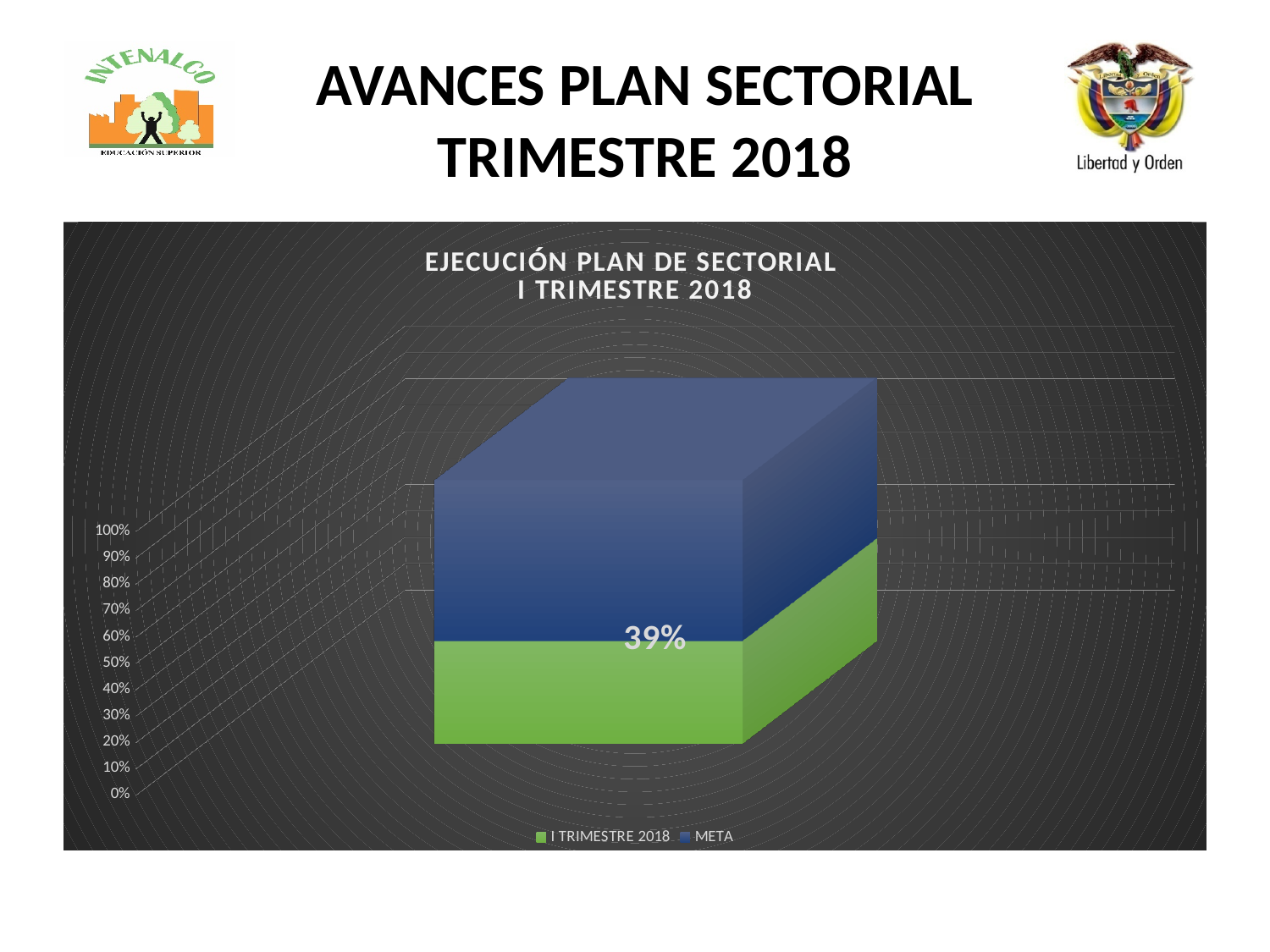
Is the value for I TRIMESTRE 2018 greater or less than 30%? greater What colour represents the META series in the chart? Blue What kind of chart is shown on the slide? Bar chart What is the value shown for the I TRIMESTRE 2018 series? 39% Is the value for I TRIMESTRE 2018 greater or less than 50%? less Which series occupies the larger portion of the stacked bar, I TRIMESTRE 2018 or META? META What is the highest value shown on the vertical axis? 100% How many series does the legend list? 2 How many bars are plotted in the chart? 1 What is the title of the chart? EJECUCIÓN PLAN DE SECTORIAL I TRIMESTRE 2018